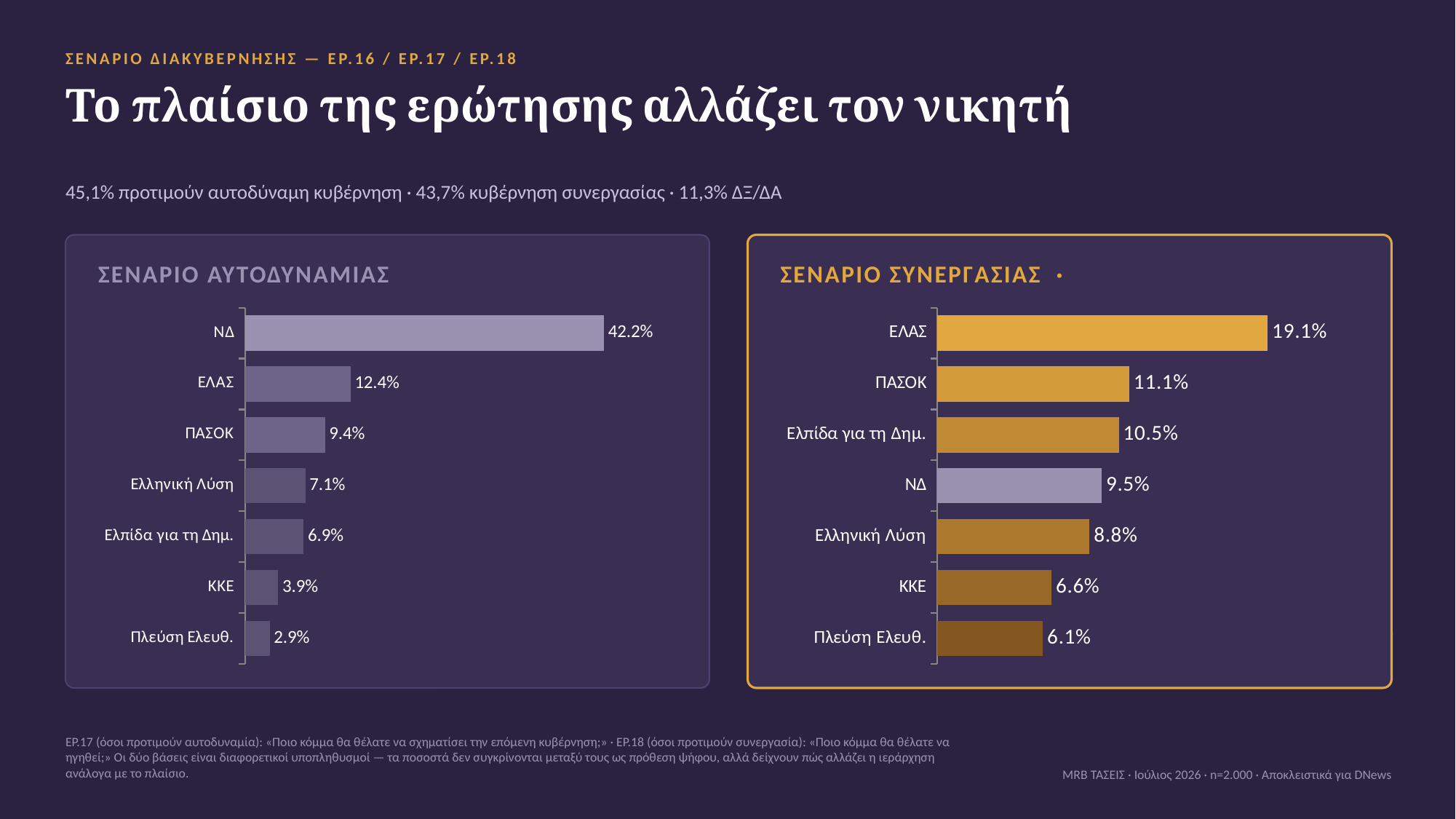
In the "ΣΕΝΑΡΙΟ ΣΥΝΕΡΓΑΣΙΑΣ" chart, what is the value for ΝΔ? 9.5% What kind of chart is the "ΣΕΝΑΡΙΟ ΑΥΤΟΔΥΝΑΜΙΑΣ" chart? Bar chart How many parties are shown in the "ΣΕΝΑΡΙΟ ΣΥΝΕΡΓΑΣΙΑΣ" chart? 7 In the "ΣΕΝΑΡΙΟ ΣΥΝΕΡΓΑΣΙΑΣ" chart, which is larger: the value for Ελπίδα για τη Δημ. or the value for Ελληνική Λύση? Ελπίδα για τη Δημ. In the "ΣΕΝΑΡΙΟ ΣΥΝΕΡΓΑΣΙΑΣ" chart, which bar is coloured differently (light purple) from the others? ΝΔ In the "ΣΕΝΑΡΙΟ ΑΥΤΟΔΥΝΑΜΙΑΣ" chart, what is the difference between the values for ΝΔ and ΕΛΑΣ? 29.8% In the "ΣΕΝΑΡΙΟ ΑΥΤΟΔΥΝΑΜΙΑΣ" chart, which party has the lowest value? Πλεύση Ελευθ. In the "ΣΕΝΑΡΙΟ ΣΥΝΕΡΓΑΣΙΑΣ" chart, what is the value for ΠΑΣΟΚ? 11.1% In the "ΣΕΝΑΡΙΟ ΑΥΤΟΔΥΝΑΜΙΑΣ" chart, which is larger: the value for ΚΚΕ or the value for Πλεύση Ελευθ.? ΚΚΕ In the "ΣΕΝΑΡΙΟ ΣΥΝΕΡΓΑΣΙΑΣ" chart, which party has the highest value? ΕΛΑΣ In the "ΣΕΝΑΡΙΟ ΣΥΝΕΡΓΑΣΙΑΣ" chart, what is the difference between the values for ΕΛΑΣ and ΠΑΣΟΚ? 8.0% In the "ΣΕΝΑΡΙΟ ΑΥΤΟΔΥΝΑΜΙΑΣ" chart, what is the value for ΝΔ? 42.2%